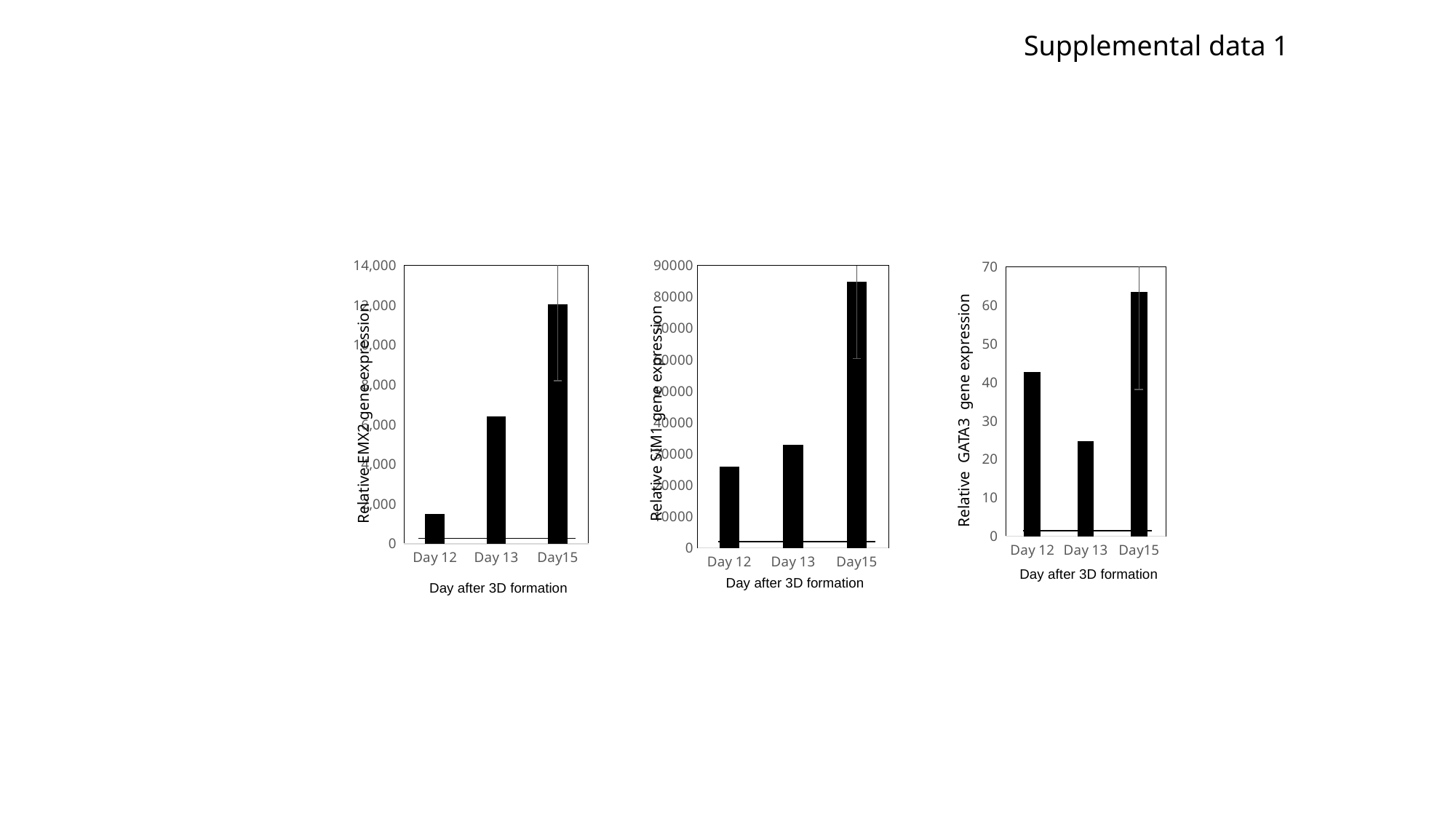
In the Relative GATA3 gene expression chart, which day has the lowest value? Day 13 In the Relative SIM1 gene expression chart, is the value for Day15 greater or less than 80000? greater What is the x-axis title of the Relative GATA3 gene expression chart? Day after 3D formation In the Relative GATA3 gene expression chart, which is larger, Day 12 or Day 13? Day 12 In the Relative EMX2 gene expression chart, is the value for Day 13 greater or less than 4,000? greater In the Relative EMX2 gene expression chart, do the values rise or fall from Day 12 to Day15? rise In the Relative SIM1 gene expression chart, which is larger, Day 13 or Day15? Day15 What kind of chart is the left chart, Relative EMX2 gene expression? bar chart How many categories are shown on the x axis of the Relative SIM1 gene expression chart? 3 In the Relative EMX2 gene expression chart, is the value for Day15 greater or less than 10,000? greater In the Relative EMX2 gene expression chart, which day has the highest value? Day15